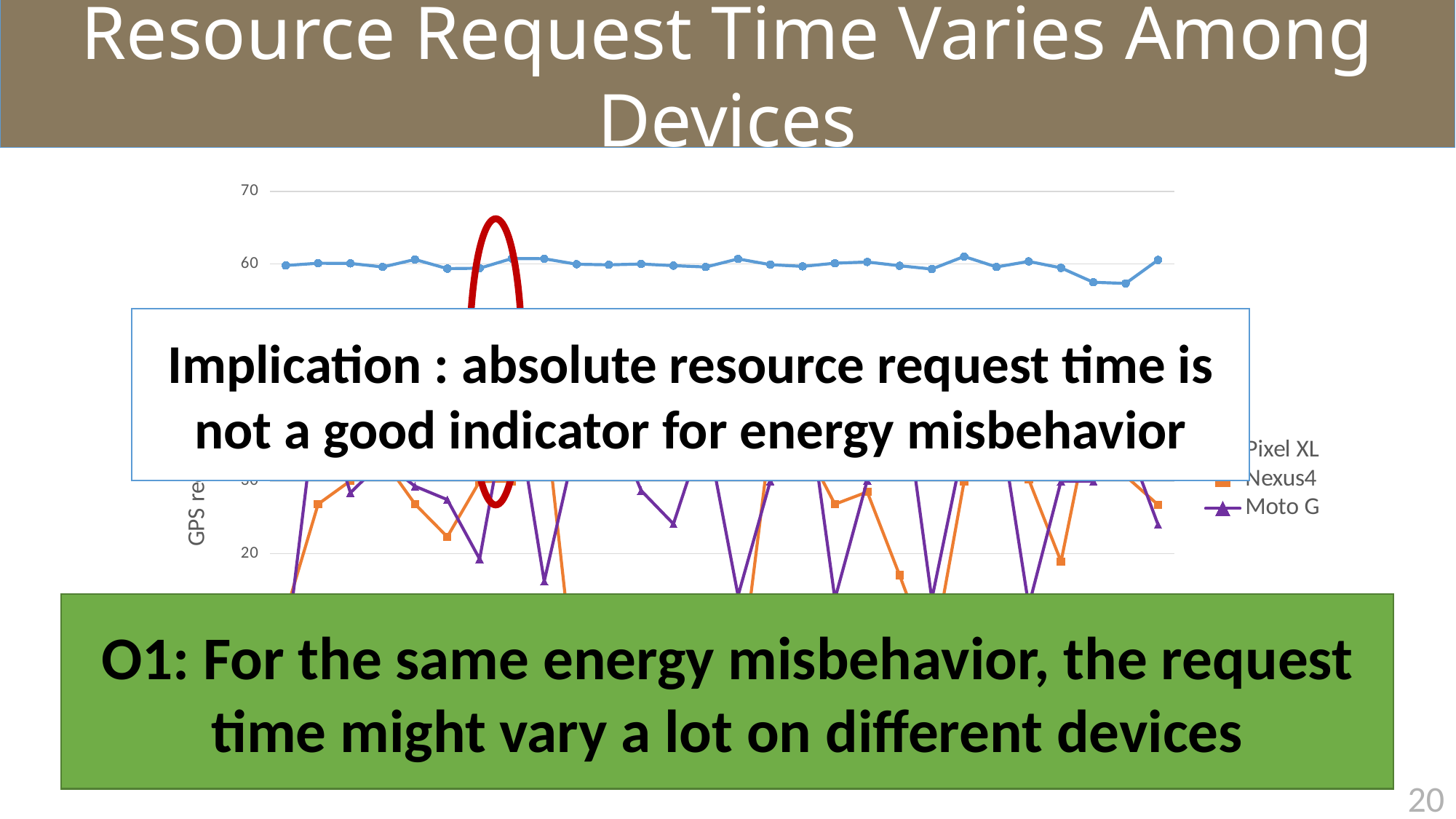
What kind of chart is shown on the slide? line chart What is the highest value shown on the chart's y axis? 70 Which series has larger values overall, Pixel XL or Nexus4? Pixel XL How many series does the chart's legend list? 3 Is the value of the Pixel XL series at its first point greater or less than 50? greater Which series consistently has the highest values in the chart? Pixel XL Does the Pixel XL series rise, fall, or stay roughly flat along the x axis? roughly flat Which series has larger values overall, Pixel XL or Moto G? Pixel XL Which devices are listed in the chart's legend? Pixel XL, Nexus4, Moto G Which series is plotted with the blue line and circle markers? Pixel XL Is the value of the Pixel XL series at its last point greater or less than 70? less